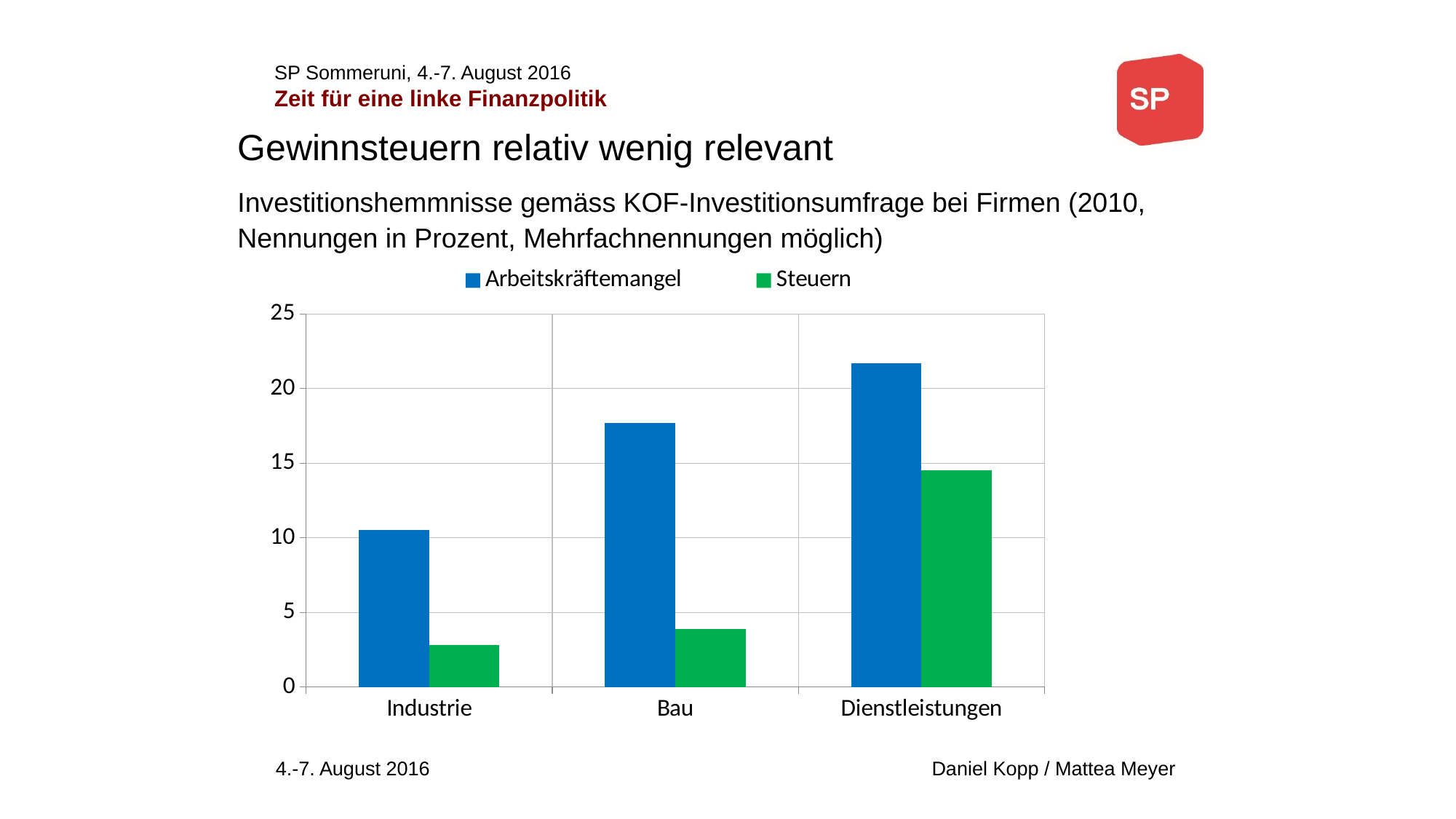
Which category has the lowest value for Arbeitskräftemangel? Industrie Is the value for Arbeitskräftemangel in Dienstleistungen greater or less than 20? greater Which category has the highest value for Arbeitskräftemangel? Dienstleistungen Is the value for Arbeitskräftemangel in Bau greater or less than 15? greater How many series does the legend list? 2 How many categories are shown on the x axis? 3 Is the value for Steuern in Bau greater or less than 5? less Which category has the lowest value for Steuern? Industrie What kind of chart is shown on the slide? bar chart In Bau, which series has the larger value, Arbeitskräftemangel or Steuern? Arbeitskräftemangel Do the Arbeitskräftemangel values rise or fall from Industrie to Dienstleistungen? rise